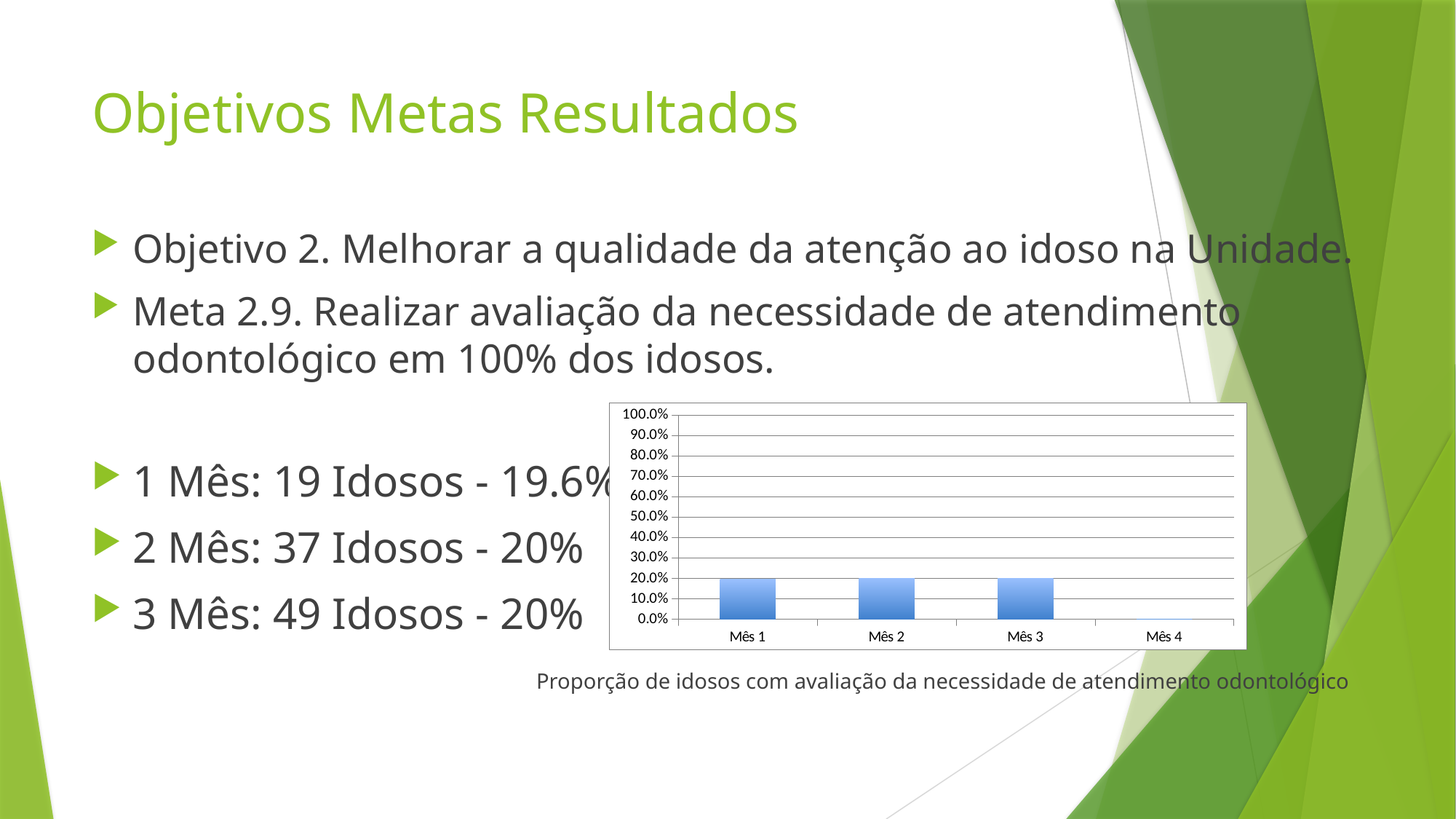
Which category has the lowest value in the chart? Mês 4 Does the value fall or rise from Mês 3 to Mês 4? fall What is the highest tick value shown on the y axis of the chart? 100.0% Is the value for Mês 4 greater or less than 10.0%? less Is the value for Mês 2 greater or less than 10.0%? greater How many categories are shown on the x axis of the chart? 4 Is the value for Mês 3 greater or less than 50.0%? less What caption is written below the chart? Proporção de idosos com avaliação da necessidade de atendimento odontológico What kind of chart is shown on the slide? bar chart Which is larger, the value for Mês 2 or the value for Mês 4? Mês 2